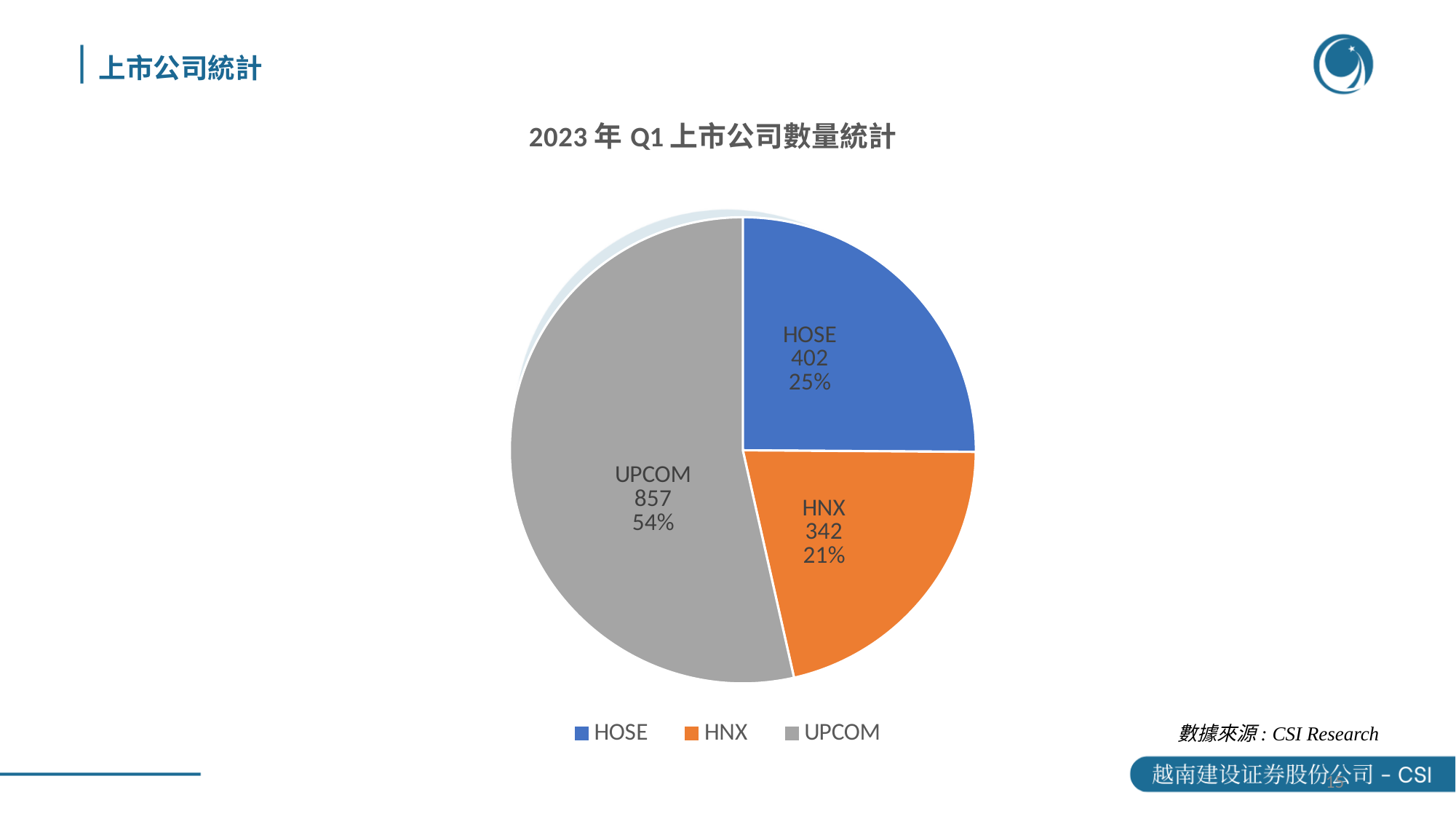
Which has more listed companies, HOSE or HNX? HOSE How many listed companies does the UPCOM slice show? 857 What share of the pie does HNX represent? 21% What share of the pie does HOSE represent? 25% What is the difference between the number of listed companies on UPCOM and on HOSE? 455 How many listed companies does the HOSE slice show? 402 How many listed companies does the HNX slice show? 342 Which exchange has the smallest number of listed companies? HNX What share of the pie does UPCOM represent? 54% What type of chart is shown on the slide? pie chart Which exchange has the largest number of listed companies? UPCOM How many slices does the pie chart have? 3